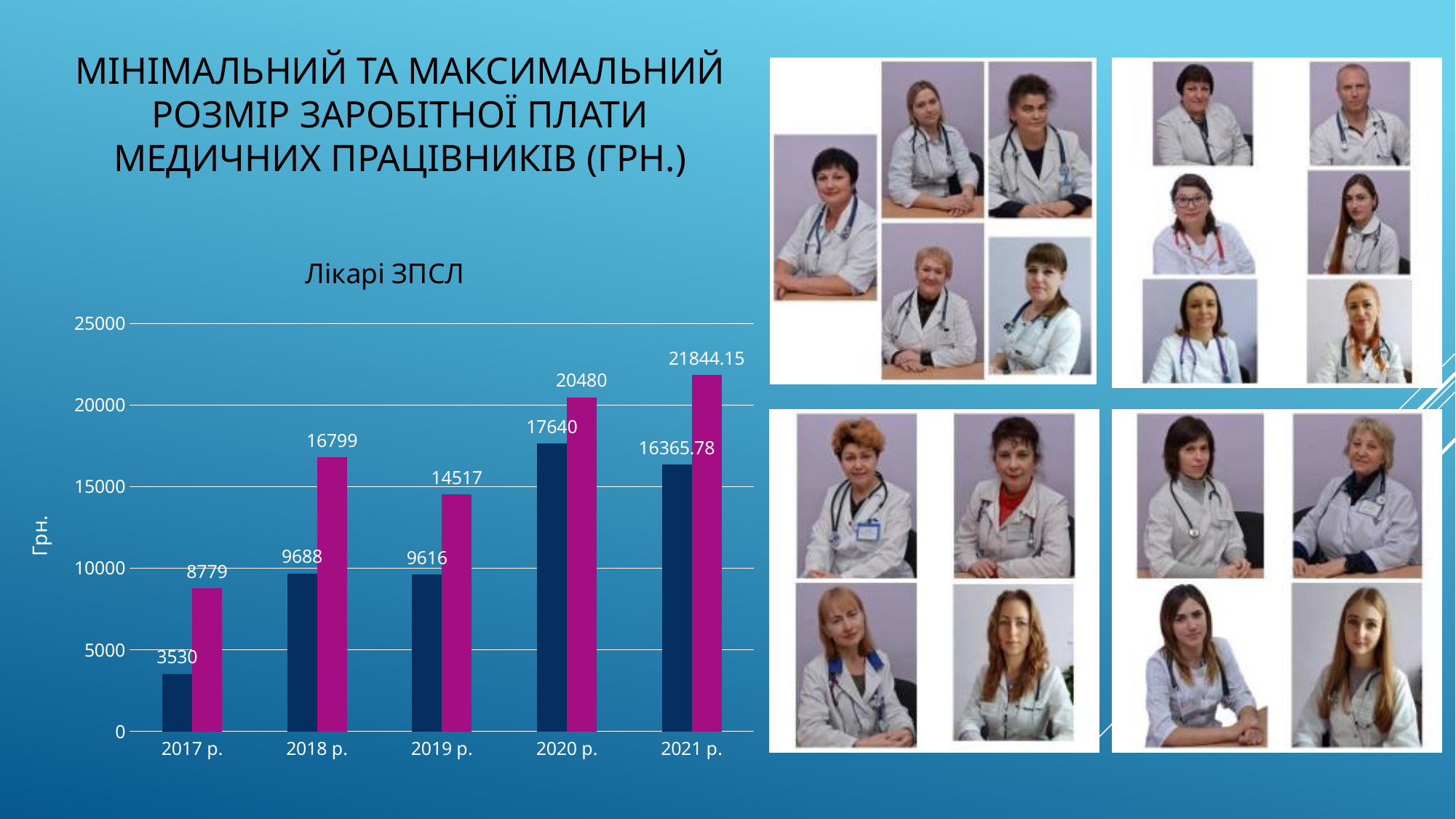
Which year has the larger dark blue bar value, 2018 р. or 2019 р.? 2018 р. What is the title of the chart? Лікарі ЗПСЛ How many years are shown on the x axis of the chart? 5 What is the value of the magenta bar for 2019 р.? 14517 What is the value of the dark blue bar for 2017 р. in the Лікарі ЗПСЛ chart? 3530 In which year is the dark blue bar the lowest? 2017 р. What kind of chart is shown on the slide? bar chart What is the value of the magenta bar for 2021 р. in the Лікарі ЗПСЛ chart? 21844.15 What is the difference between the magenta and dark blue bars for 2021 р.? 5478.37 Is the value of the magenta bar for 2018 р. greater or less than 15000? greater In which year is the magenta bar the highest? 2021 р. What is the difference between the magenta and dark blue bars for 2020 р.? 2840